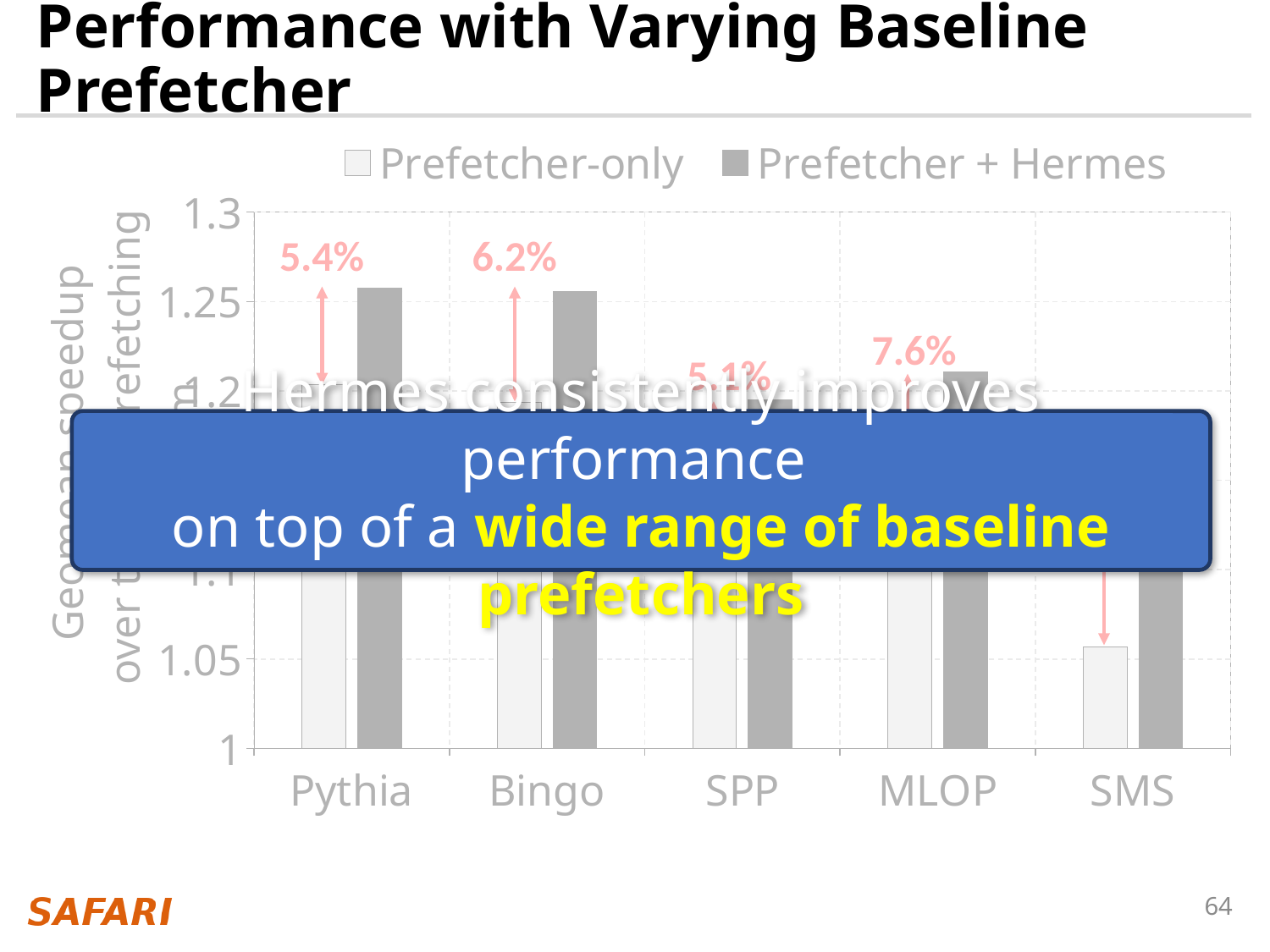
Is the Prefetcher + Hermes value for Pythia greater or less than 1.25? greater What percentage improvement is labeled above the SPP bars? 5.1% How many series does the chart legend list? 2 Among Pythia, Bingo, SPP and MLOP, which prefetcher has the largest labeled improvement from Hermes? MLOP Is the Prefetcher-only value for SMS greater or less than 1.1? less How many baseline prefetchers are shown along the x axis? 5 What percentage improvement is labeled above the MLOP bars? 7.6% What kind of chart is shown on the slide? bar chart What percentage improvement is labeled above the Pythia bars? 5.4% What are the two series named in the legend? Prefetcher-only and Prefetcher + Hermes What percentage improvement is labeled above the Bingo bars? 6.2% What is the title of the chart's slide? Performance with Varying Baseline Prefetcher